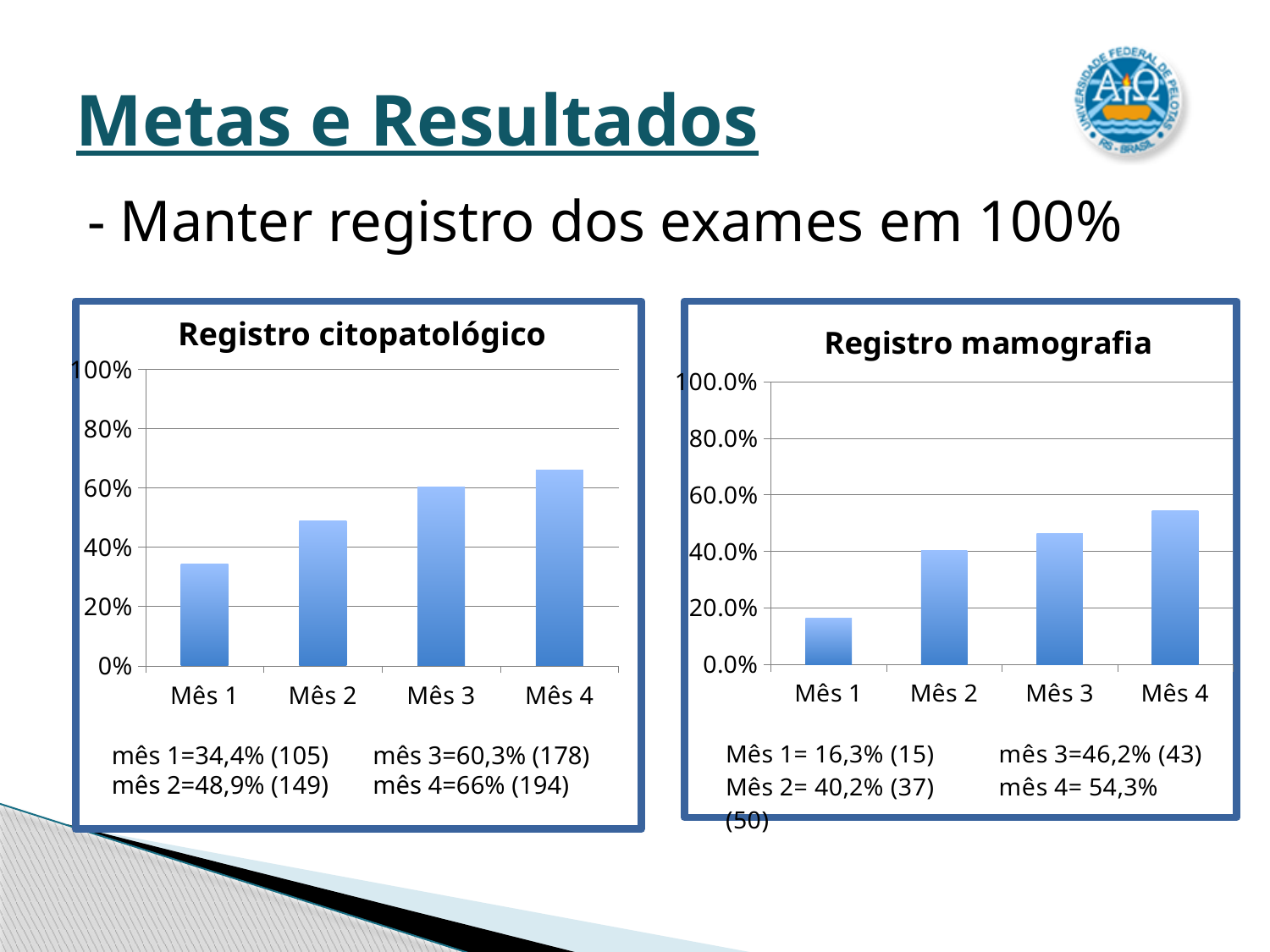
In the "Registro mamografia" chart, which month has the lowest value? Mês 1 Using the values printed under the "Registro citopatológico" chart, what is the difference between mês 4 and mês 1? 31,6% What type of chart is the "Registro citopatológico" chart? bar chart According to the text under the "Registro mamografia" chart, what is the value for mês 3? 46,2% In the "Registro mamografia" chart, is the value for Mês 1 greater or less than 20.0%? less What is the title of the chart on the right side of the slide? Registro mamografia Do the values in the "Registro mamografia" chart rise or fall from Mês 1 to Mês 4? rise In the "Registro citopatológico" chart, which is larger, the value for Mês 2 or the value for Mês 3? Mês 3 In the "Registro citopatológico" chart, is the value for Mês 4 greater or less than 60%? greater In the "Registro citopatológico" chart, which month has the highest value? Mês 4 How many months are shown on the x axis of the "Registro mamografia" chart? 4 According to the text under the "Registro citopatológico" chart, what is the value for mês 1? 34,4%